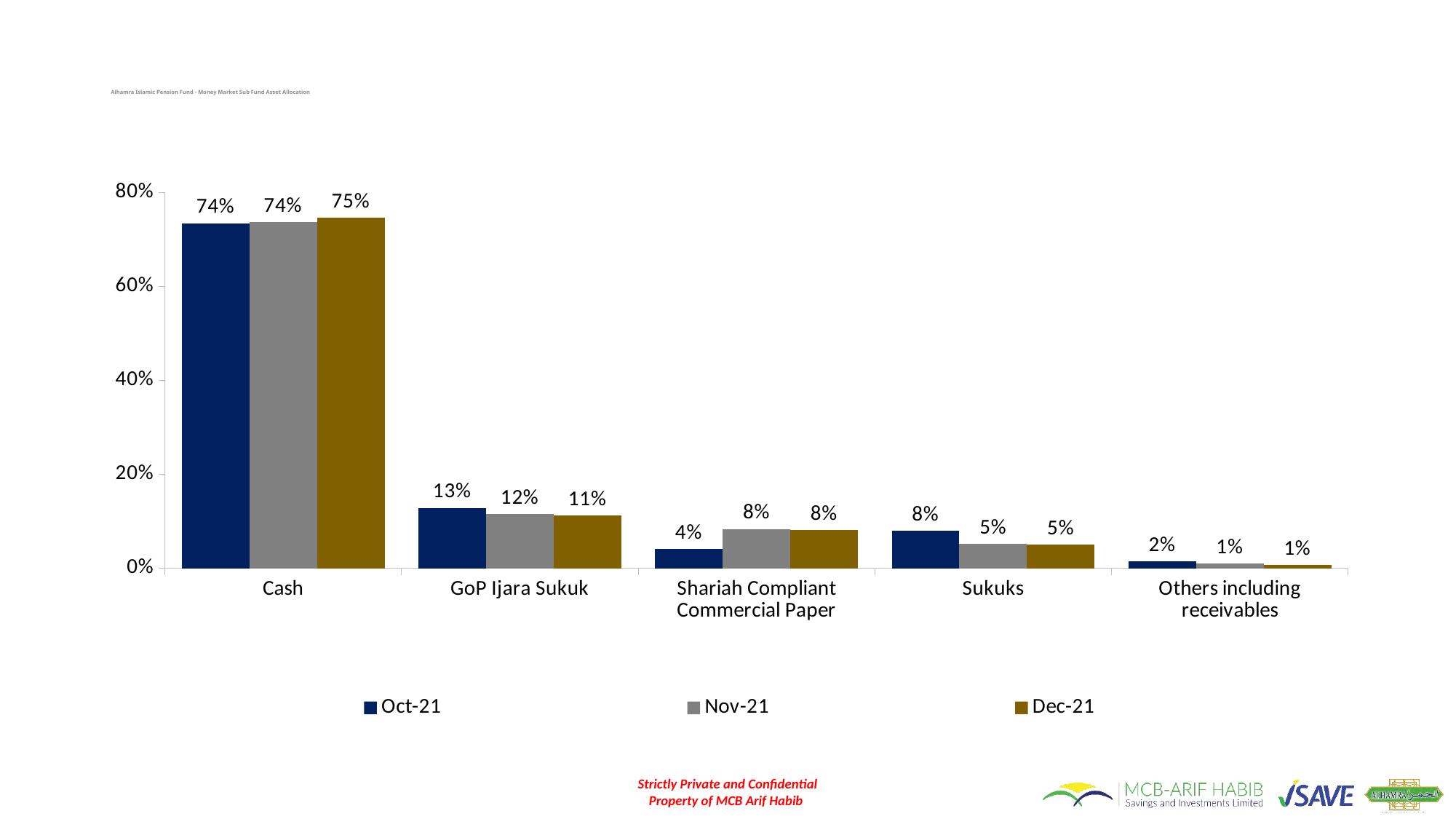
What is the difference between the Oct-21 and Dec-21 values for GoP Ijara Sukuk? 2% What is the Dec-21 value for Cash? 75% Which is larger for Sukuks: the Oct-21 value or the Nov-21 value? Oct-21 What is the Nov-21 value for Shariah Compliant Commercial Paper? 8% What is the Oct-21 value for Sukuks? 8% What is the Oct-21 value for GoP Ijara Sukuk? 13% Which category has the highest Dec-21 value? Cash Which legend entry is shown in gray? Nov-21 How many series does the legend list? 3 Which category has the lowest Oct-21 value? Others including receivables How many categories are shown on the x axis? 5 What kind of chart is shown on the slide? Bar chart